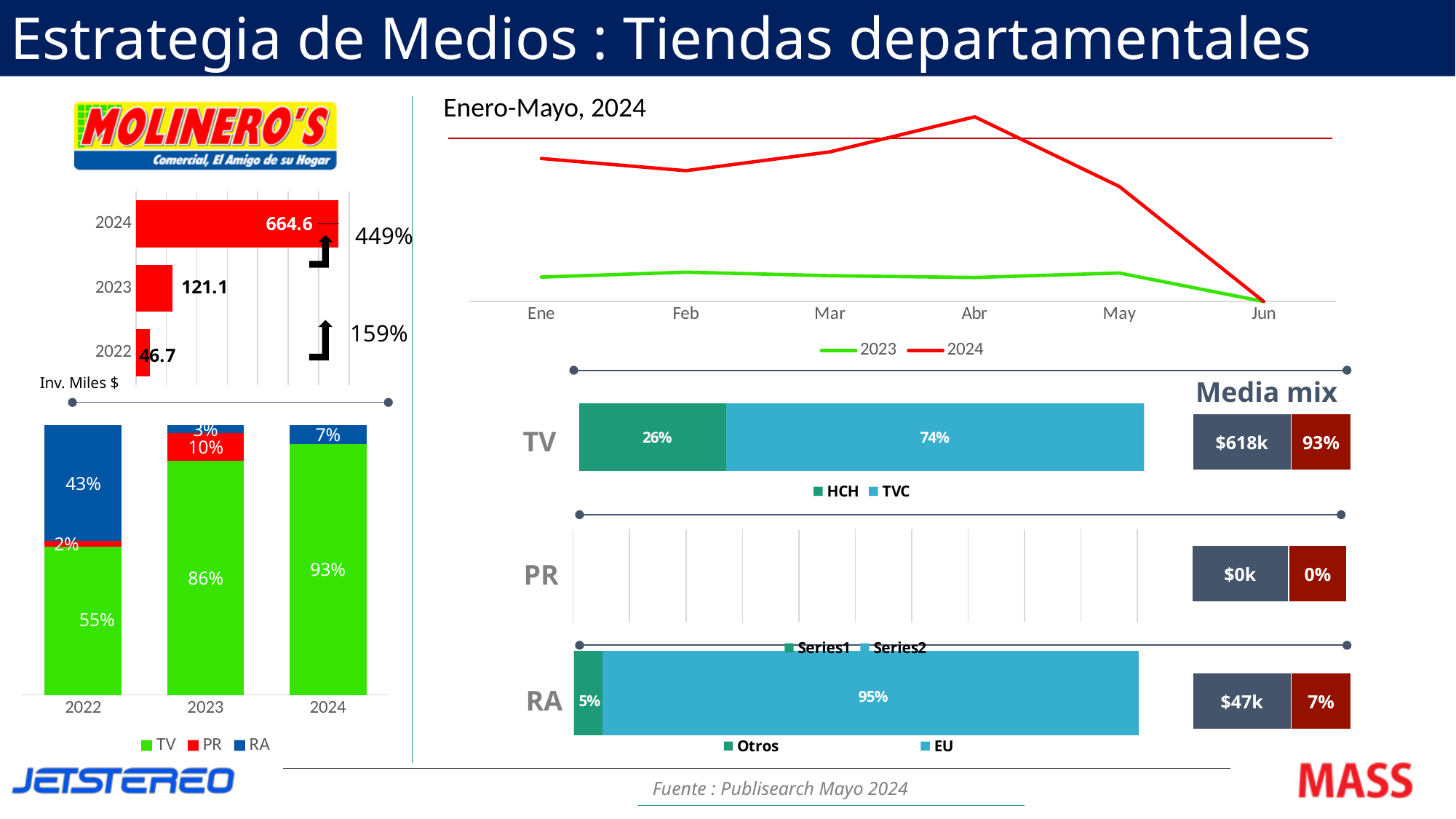
In the bottom-left stacked bar chart, what is the TV share for 2023? 86% In the line chart titled Enero-Mayo, 2024, how many months are shown on the x axis? 6 In the bottom-left stacked bar chart, what is the RA share for 2022? 43% In the top-left bar chart of investment (Inv. Miles $), what is the value for 2024? 664.6 In the line chart titled Enero-Mayo, 2024, does the 2024 line rise or fall from Abr to Jun? fall In the top-left bar chart of investment (Inv. Miles $), what is the value for 2022? 46.7 How many series does the legend of the bottom-left stacked bar chart list? 3 In the line chart titled Enero-Mayo, 2024, in which month does the 2024 line reach its highest point? Abr In the top-left bar chart of investment, which year has the lowest value? 2022 In the top-left bar chart of investment, what is the difference between the 2024 and 2023 values? 543.5 What kind of chart is the top-left chart showing investment by year? bar chart In the TV stacked bar on the right, what is the share for HCH? 26%